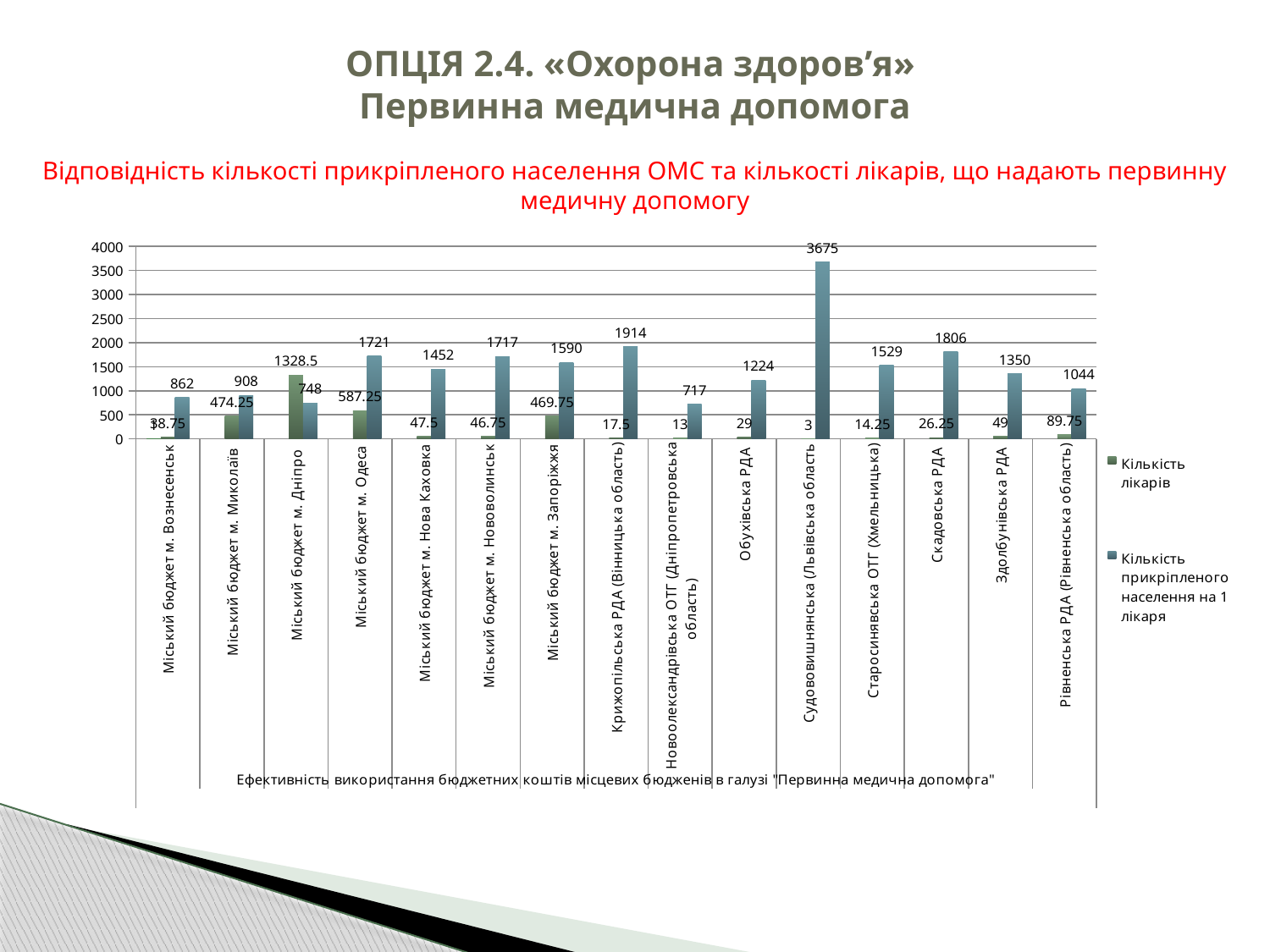
What is the value of 'Кількість лікарів' for Міський бюджет м. Дніпро? 1328.5 Which category has the lowest value of 'Кількість прикріпленого населення на 1 лікаря'? Новоолександрівська ОТГ (Дніпропетровська область) What is the value of 'Кількість прикріпленого населення на 1 лікаря' for Крижопільська РДА (Вінницька область)? 1914 What is the value of 'Кількість прикріпленого населення на 1 лікаря' for Судововишнянська (Львівська область)? 3675 Which category has the highest value of 'Кількість прикріпленого населення на 1 лікаря'? Судововишнянська (Львівська область) How many categories are shown on the x axis of the chart? 15 Which has a larger 'Кількість прикріпленого населення на 1 лікаря': Міський бюджет м. Запоріжжя or Міський бюджет м. Нова Каховка? Міський бюджет м. Запоріжжя What is the value of 'Кількість лікарів' for Рівненська РДА (Рівненська область)? 89.75 How many series does the legend list? 2 What type of chart is shown on the slide? bar chart Which category has the lowest value of 'Кількість лікарів'? Судововишнянська (Львівська область) What is the difference in 'Кількість прикріпленого населення на 1 лікаря' between Міський бюджет м. Одеса and Міський бюджет м. Вознесенськ? 859